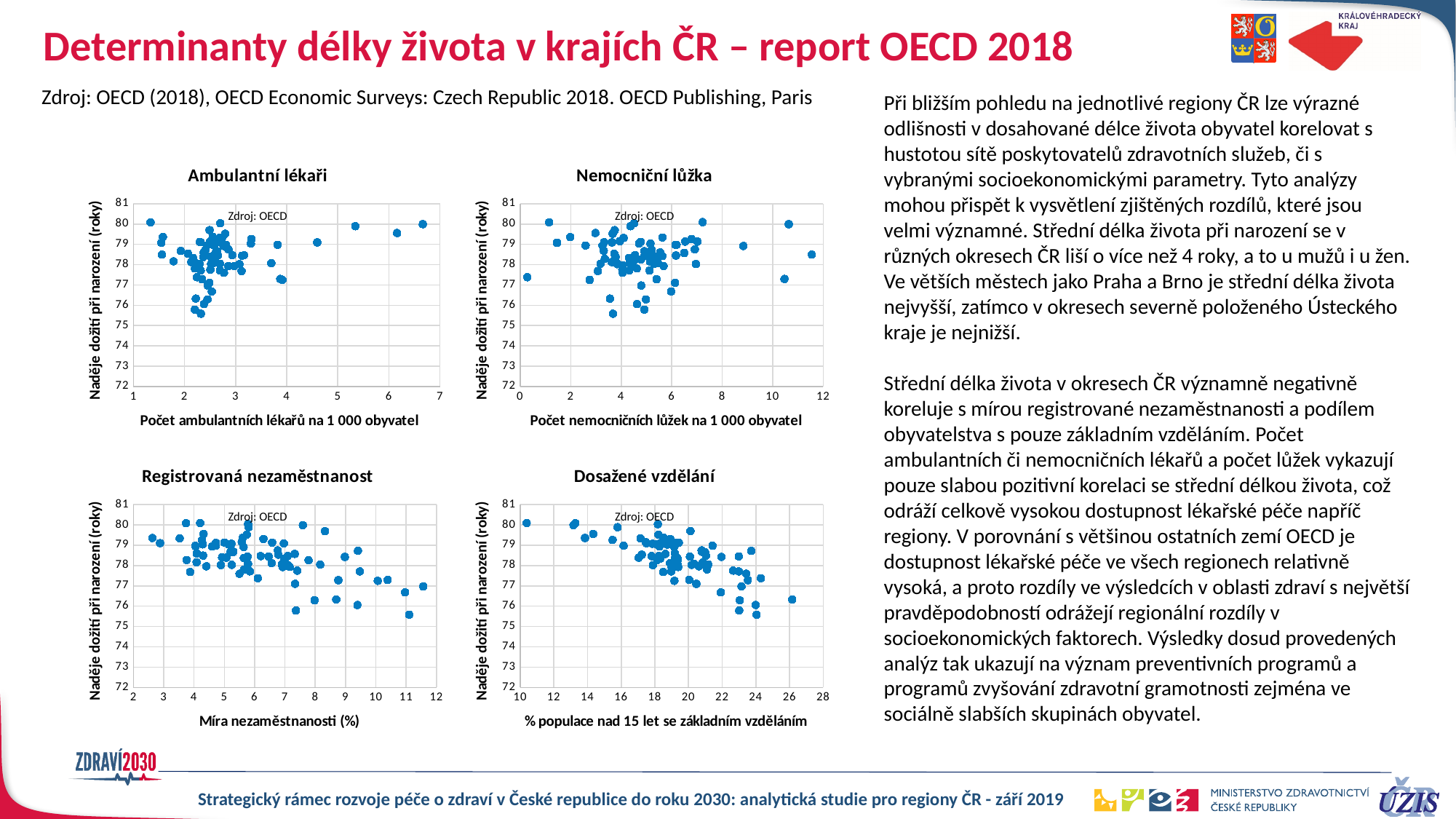
What is the x-axis title of the 'Nemocniční lůžka' chart? Počet nemocničních lůžek na 1 000 obyvatel What is the title of the chart in the bottom-right position? Dosažené vzdělání How many charts are shown on the slide? 4 In the 'Registrovaná nezaměstnanost' chart, do the life expectancy values generally rise or fall as the unemployment rate increases? fall What is the highest value shown on the y-axis of the 'Ambulantní lékaři' chart? 81 In the 'Dosažené vzdělání' chart, do the life expectancy values generally rise or fall as the share of population with basic education increases? fall What is the maximum value shown on the x-axis of the 'Dosažené vzdělání' chart? 28 In the 'Nemocniční lůžka' chart, is the lowest plotted life expectancy greater or less than 77? less In the 'Registrovaná nezaměstnanost' chart, is the highest plotted life expectancy greater or less than 79? greater What kind of chart is the 'Ambulantní lékaři' chart? scatter chart What is the lowest value shown on the y-axis of the 'Dosažené vzdělání' chart? 72 In the 'Ambulantní lékaři' chart, is the lowest plotted life expectancy greater or less than 77? less